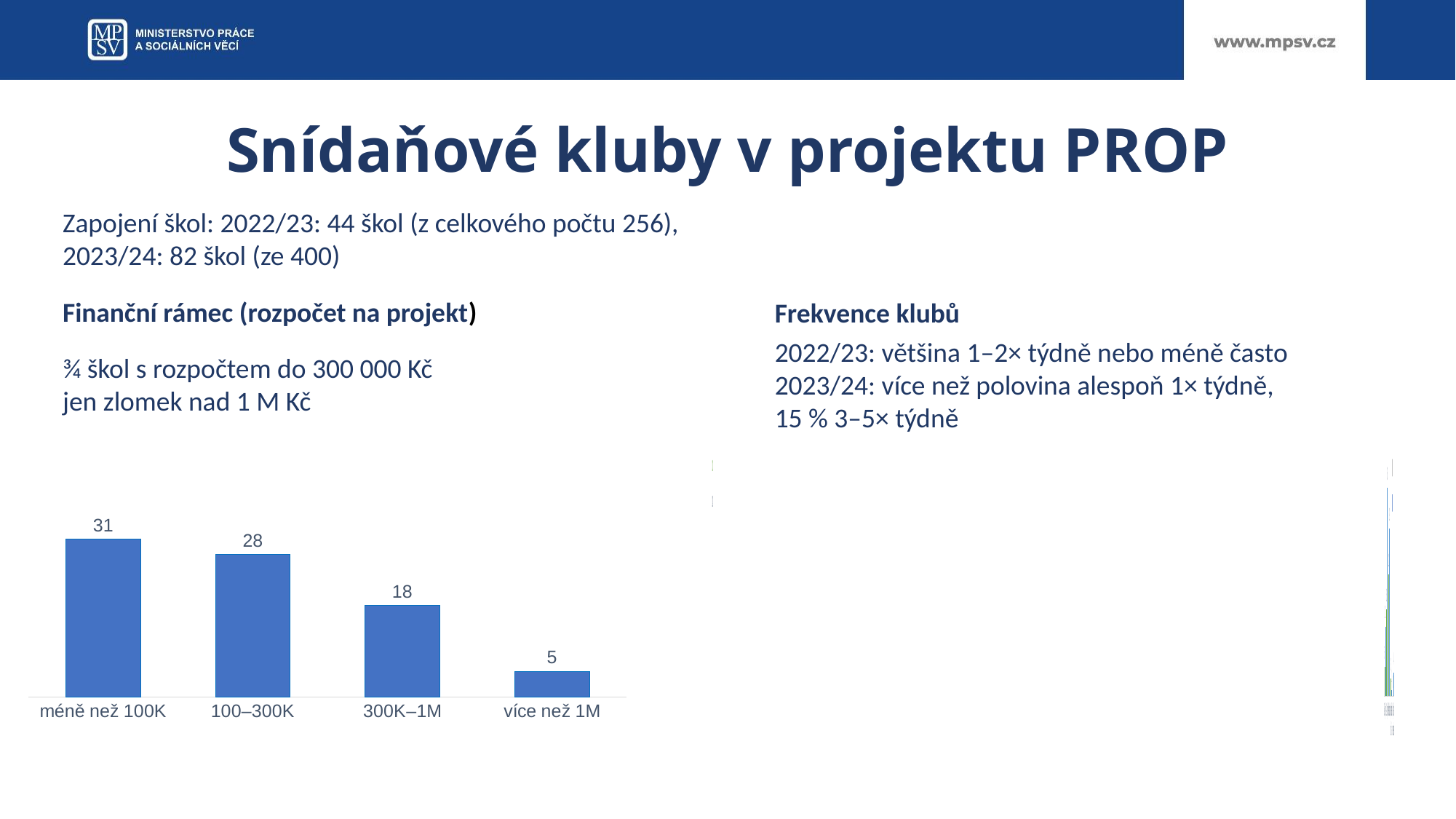
In the bar chart on the left of the slide, which is larger: the value for '300K–1M' or the value for 'více než 1M'? 300K–1M In the bar chart on the left of the slide, what is the value for '300K–1M'? 18 How many categories are shown in the bar chart on the left of the slide? 4 What kind of chart is shown on the left of the slide under 'Finanční rámec'? bar chart In the bar chart on the left of the slide, which category has the highest value? méně než 100K In the bar chart on the left of the slide, what is the difference between the values for 'méně než 100K' and 'více než 1M'? 26 In the bar chart on the left of the slide, what is the value for '100–300K'? 28 In the bar chart on the left of the slide, what is the difference between the values for '100–300K' and '300K–1M'? 10 In the bar chart on the left of the slide, do the values rise or fall from left to right along the x axis? fall In the bar chart on the left of the slide, what is the value for 'méně než 100K'? 31 In the bar chart on the left of the slide, which category has the lowest value? více než 1M In the bar chart on the left of the slide, what is the value for 'více než 1M'? 5